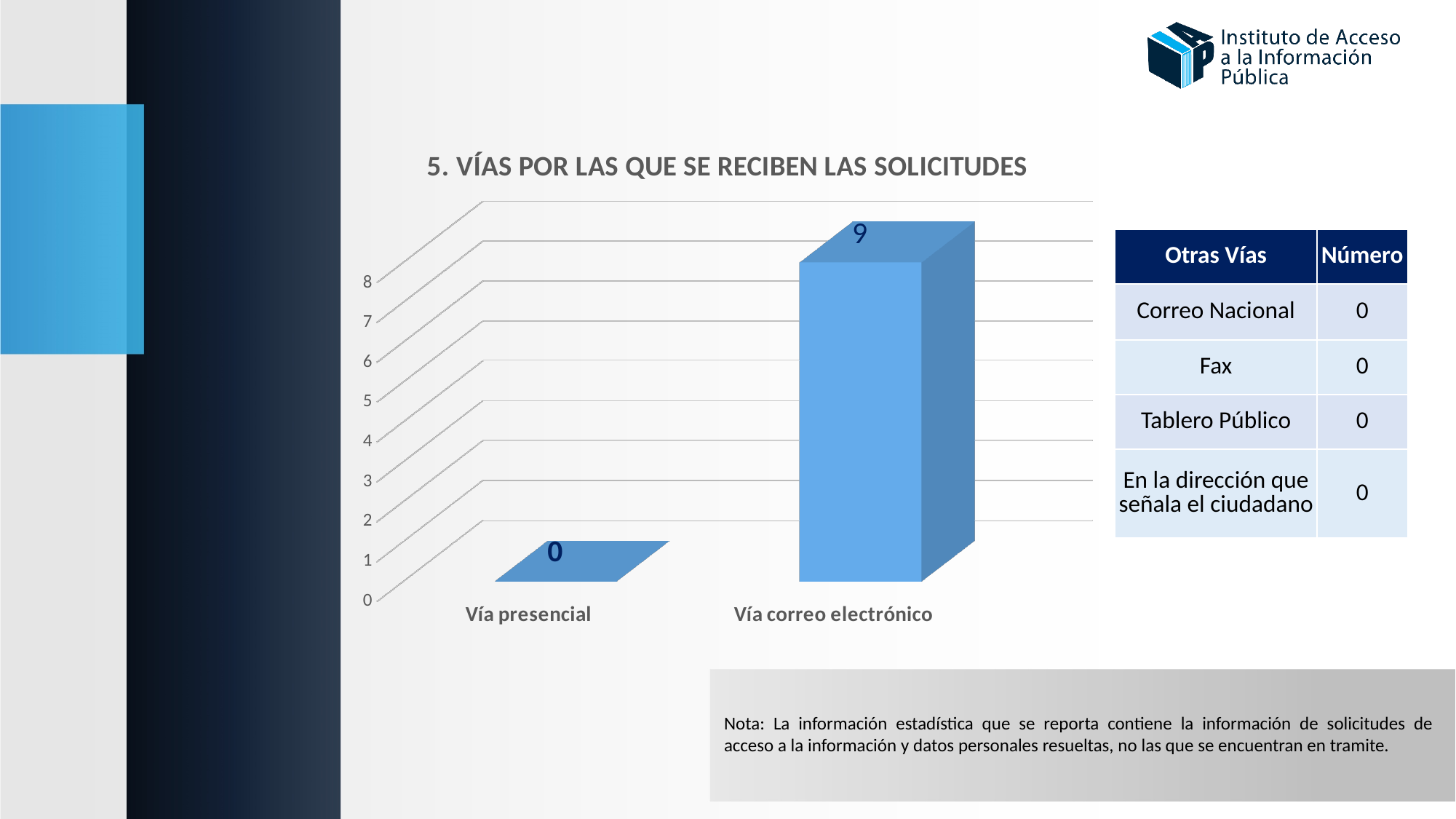
Which category has the highest value? Vía correo electrónico What is the difference between the values for Vía correo electrónico and Vía presencial? 9 What is the value for Vía presencial? 0 Which is larger, the value for Vía presencial or the value for Vía correo electrónico? Vía correo electrónico Which category has the lowest value? Vía presencial How many categories are shown on the x axis of the chart? 2 Is the value for Vía correo electrónico greater or less than 5? greater What kind of chart is shown on the slide? bar chart What is the title of the chart? 5. VÍAS POR LAS QUE SE RECIBEN LAS SOLICITUDES What is the value for Vía correo electrónico? 9 What is the highest value shown on the chart's vertical axis? 8